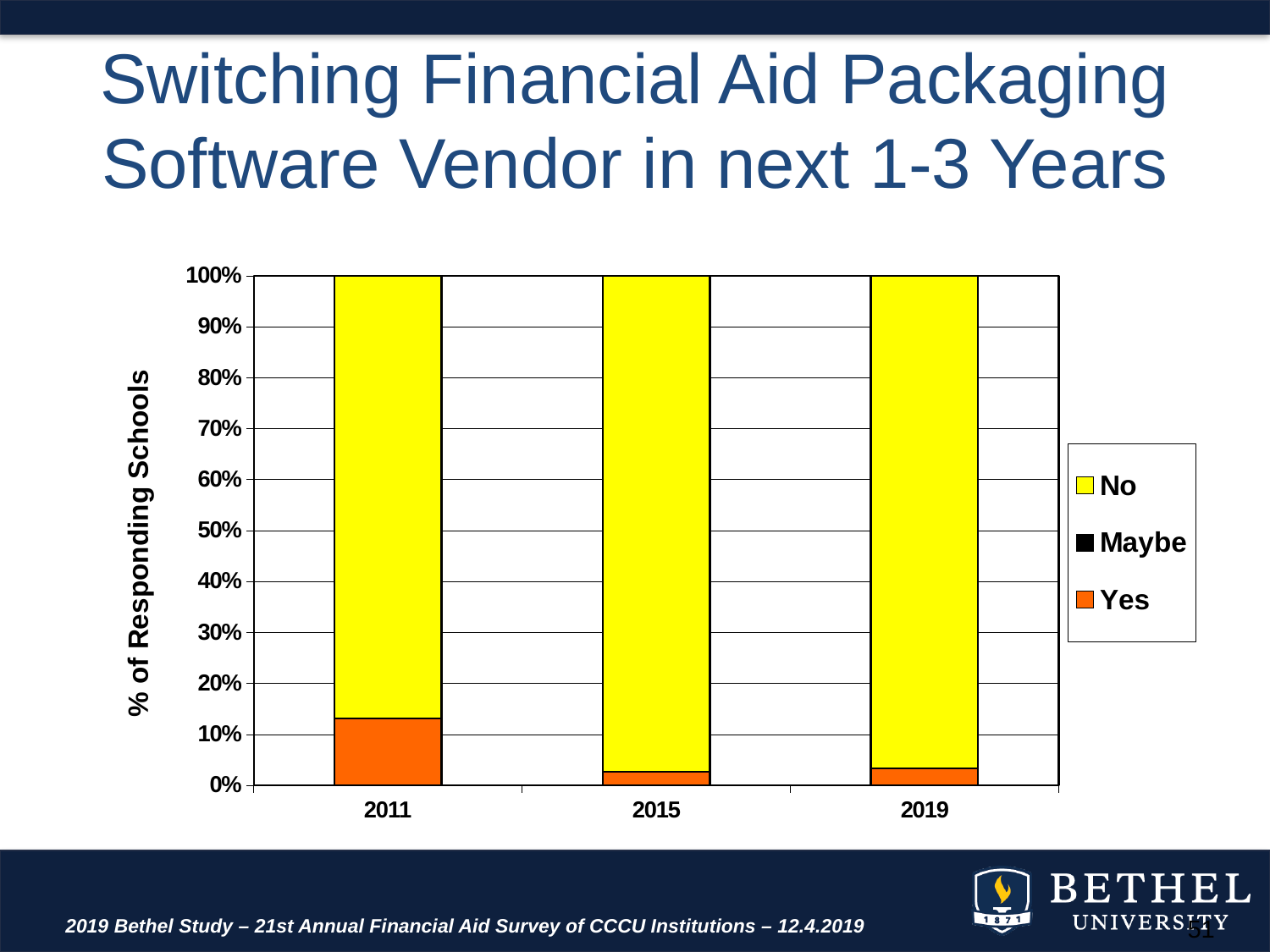
Is the 'Yes' value for 2015 greater or less than 10%? less What kind of chart is shown on the slide? Stacked bar chart Which is larger, the 'Yes' share in 2011 or in 2019? 2011 Is the 'No' value for 2011 greater or less than 90%? less What is the total height of the stacked bar for 2011? 100% Does the 'No' share rise or fall from 2011 to 2015? rise Is the 'Yes' value for 2011 greater or less than 10%? greater What is the label on the chart's y axis? % of Responding Schools How many years are shown on the x axis of the chart? 3 Which year has the highest 'Yes' share? 2011 How many series does the chart's legend list? 3